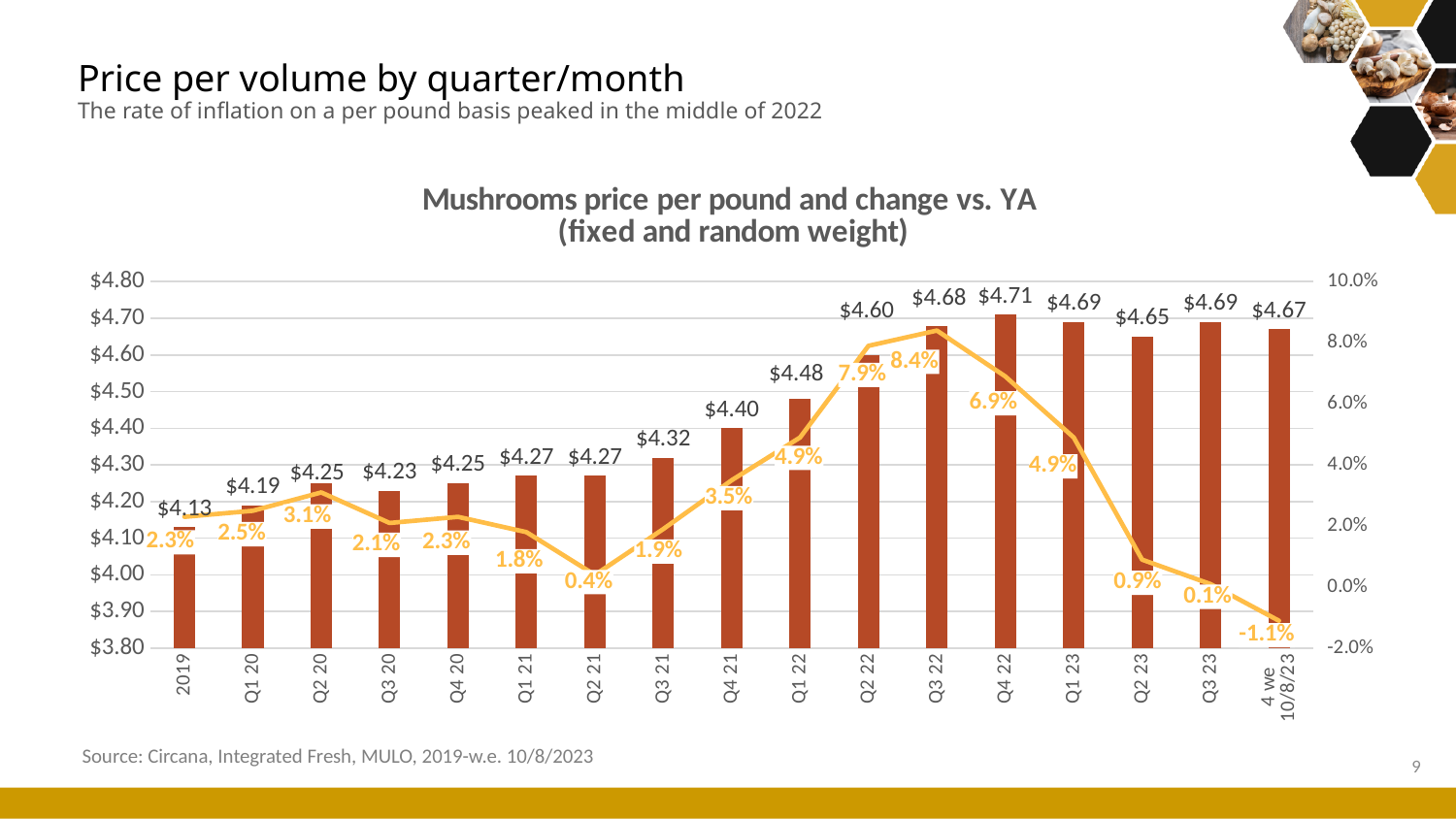
Which period has the lowest change vs. YA? 4 we 10/8/23 Does the price per pound rise or fall from 2019 to Q4 22? Rise What is the difference between the price per pound in Q4 22 and in 2019? $0.58 How many periods are shown on the x axis? 17 What kind of chart is this? Combination bar and line chart Which has the higher price per pound, Q1 22 or Q4 21? Q1 22 Which period has the lowest price per pound? 2019 Which period has the highest price per pound? Q4 22 What is the change vs. YA shown for Q3 22? 8.4% What is the title of the chart? Mushrooms price per pound and change vs. YA (fixed and random weight) What is the change vs. YA shown for the 4 we 10/8/23 period? -1.1% What is the mushrooms price per pound shown for Q4 22? $4.71